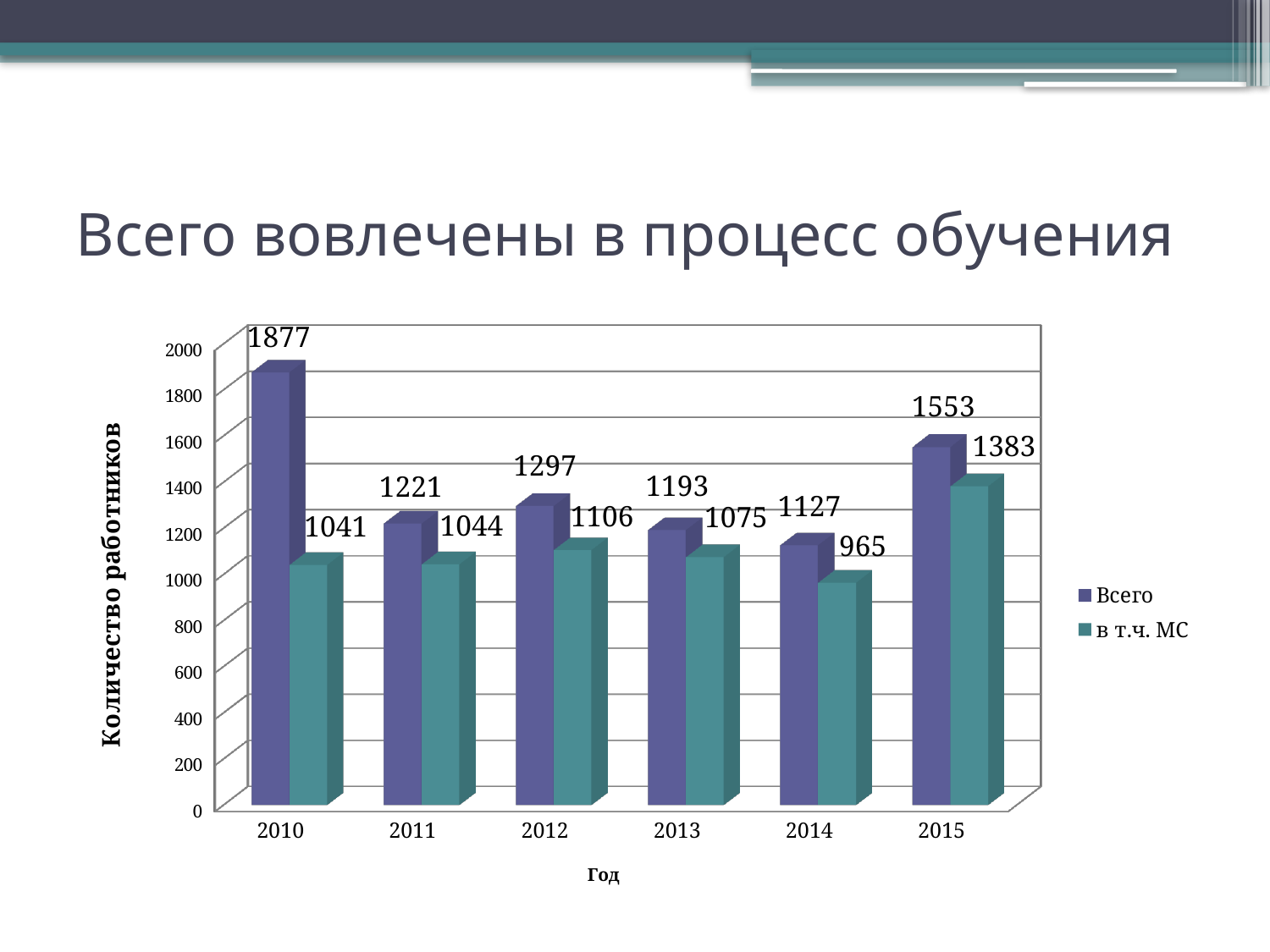
Which is larger: the 'в т.ч. МС' value for 2012 or for 2013? 2012 How many years are shown on the x axis? 6 What is the value of the 'Всего' series for 2010? 1877 What is the label of the y axis? Количество работников What is the difference between the 'Всего' values for 2015 and 2014? 426 Which year has the highest value for the 'Всего' series? 2010 What is the difference between the 'Всего' and 'в т.ч. МС' values for 2010? 836 What is the value of the 'в т.ч. МС' series for 2015? 1383 What is the value of the 'в т.ч. МС' series for 2014? 965 How many series does the legend list? 2 Which year has the lowest value for the 'в т.ч. МС' series? 2014 What kind of chart is shown on the slide? bar chart